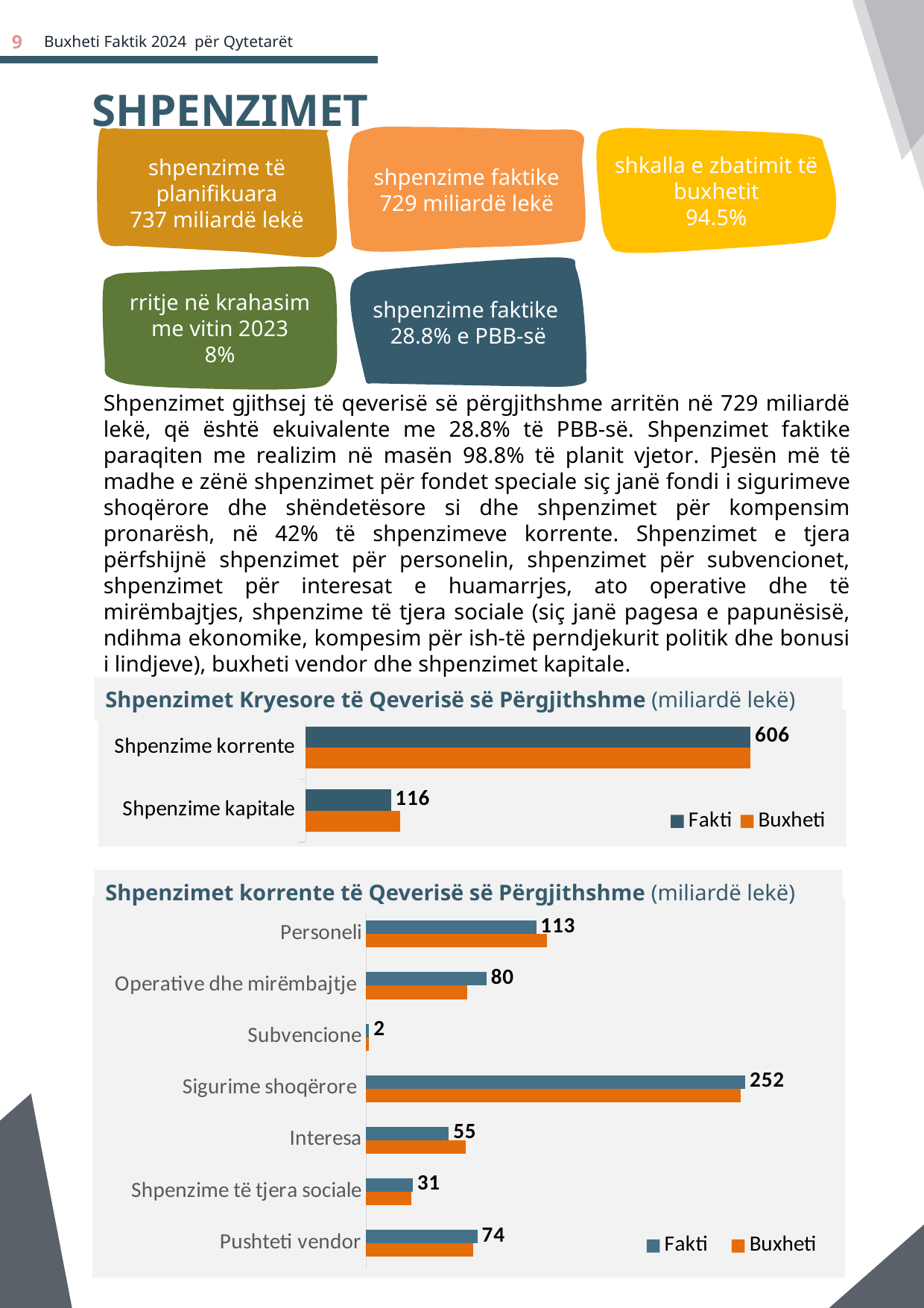
What type of chart is 'Shpenzimet korrente të Qeverisë së Përgjithshme'? Bar chart In the chart 'Shpenzimet korrente të Qeverisë së Përgjithshme', what is the Fakti value for Sigurime shoqërore? 252 In the chart 'Shpenzimet korrente të Qeverisë së Përgjithshme', which category has the lowest Fakti value? Subvencione In the chart 'Shpenzimet korrente të Qeverisë së Përgjithshme', which category has the highest Fakti value? Sigurime shoqërore In the chart 'Shpenzimet Kryesore të Qeverisë së Përgjithshme', for Shpenzime kapitale, which bar is longer: Fakti or Buxheti? Buxheti In the chart 'Shpenzimet Kryesore të Qeverisë së Përgjithshme', what is the difference between the Fakti values for Shpenzime korrente and Shpenzime kapitale? 490 In the chart 'Shpenzimet Kryesore të Qeverisë së Përgjithshme', what is the Fakti value for Shpenzime korrente? 606 In the chart 'Shpenzimet korrente të Qeverisë së Përgjithshme', what is the difference between the Fakti values for Personeli and Pushteti vendor? 39 In the chart 'Shpenzimet korrente të Qeverisë së Përgjithshme', how many categories are shown? 7 In the chart 'Shpenzimet korrente të Qeverisë së Përgjithshme', what is the Fakti value for Interesa? 55 In the chart 'Shpenzimet Kryesore të Qeverisë së Përgjithshme', how many series does the legend list? 2 In the chart 'Shpenzimet Kryesore të Qeverisë së Përgjithshme', what is the Fakti value for Shpenzime kapitale? 116